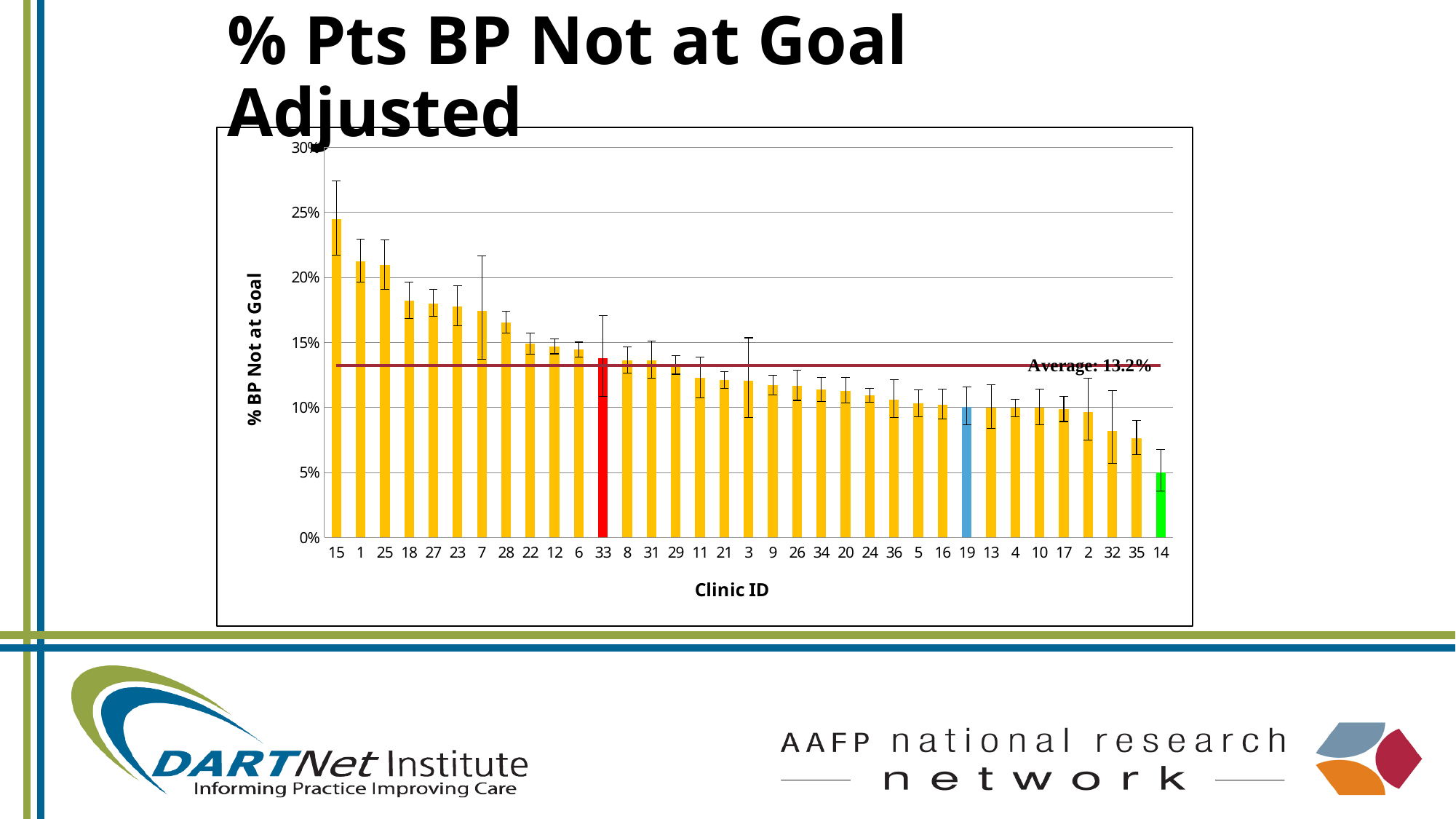
Is the value for clinic 18 greater or less than 15%? greater Which clinic ID has the lowest % BP Not at Goal? 14 What average value is labelled on the horizontal line across the chart? 13.2% Is the value for clinic 14 greater or less than 10%? less Do the bar values rise or fall moving from left to right along the x axis? fall Is the value for clinic 15 greater or less than 20%? greater How many clinics are plotted along the x axis? 35 What kind of chart is shown on the slide? bar chart Which clinic ID has the highest % BP Not at Goal? 15 What is the title of the x axis? Clinic ID Which has a higher % BP Not at Goal, clinic 25 or clinic 7? clinic 25